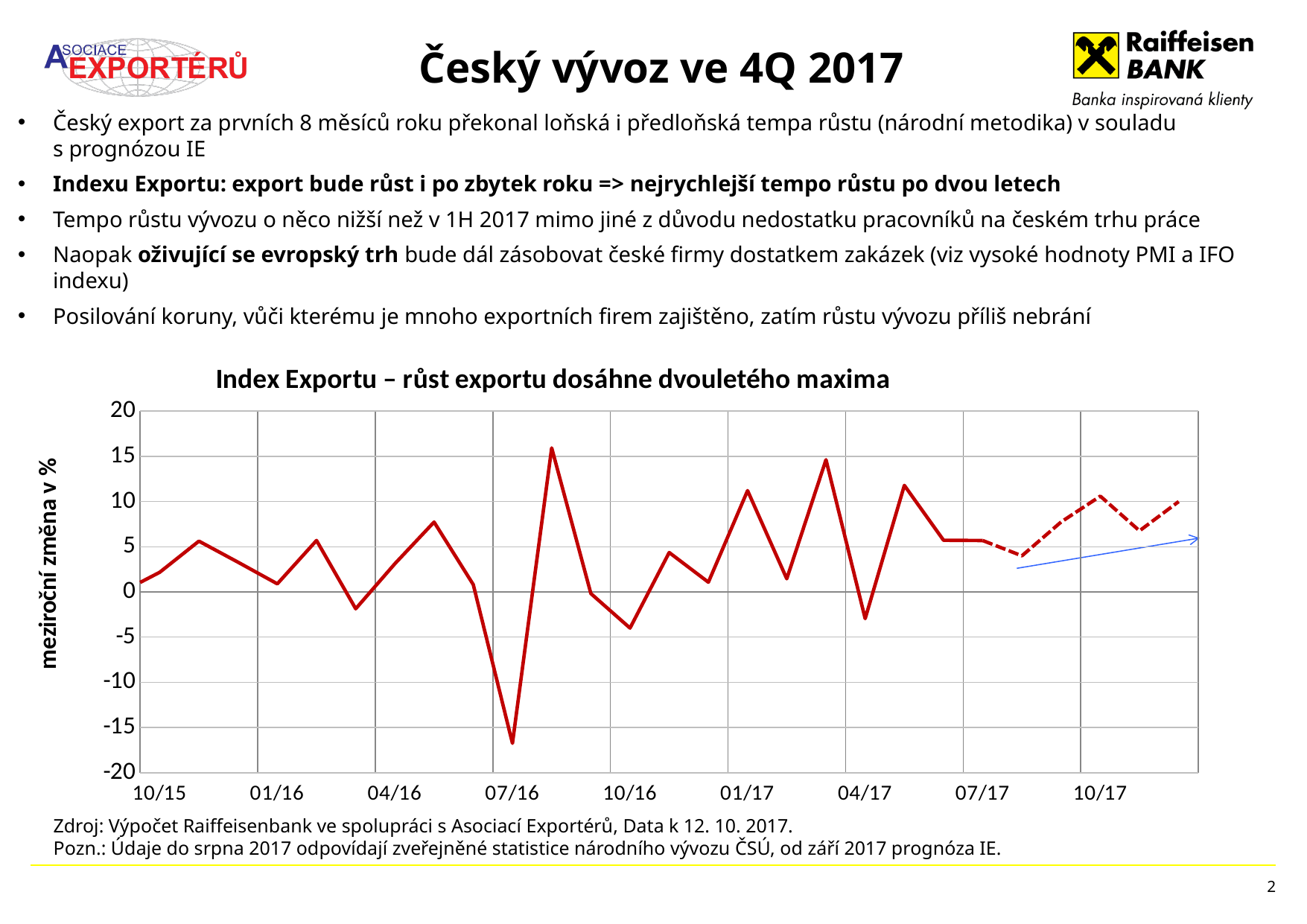
What is the label of the vertical axis of the chart? meziroční změna v % Is the value at 10/17 greater or less than 5? greater How many labelled tick marks are on the x axis? 9 Is the value at 01/17 greater or less than 5? greater What is the title of the chart? Index Exportu – růst exportu dosáhne dvouletého maxima Is the lowest value on the chart greater or less than -10? less Near which x-axis label does the line reach its lowest point? 07/16 What kind of chart is shown on the slide? line chart